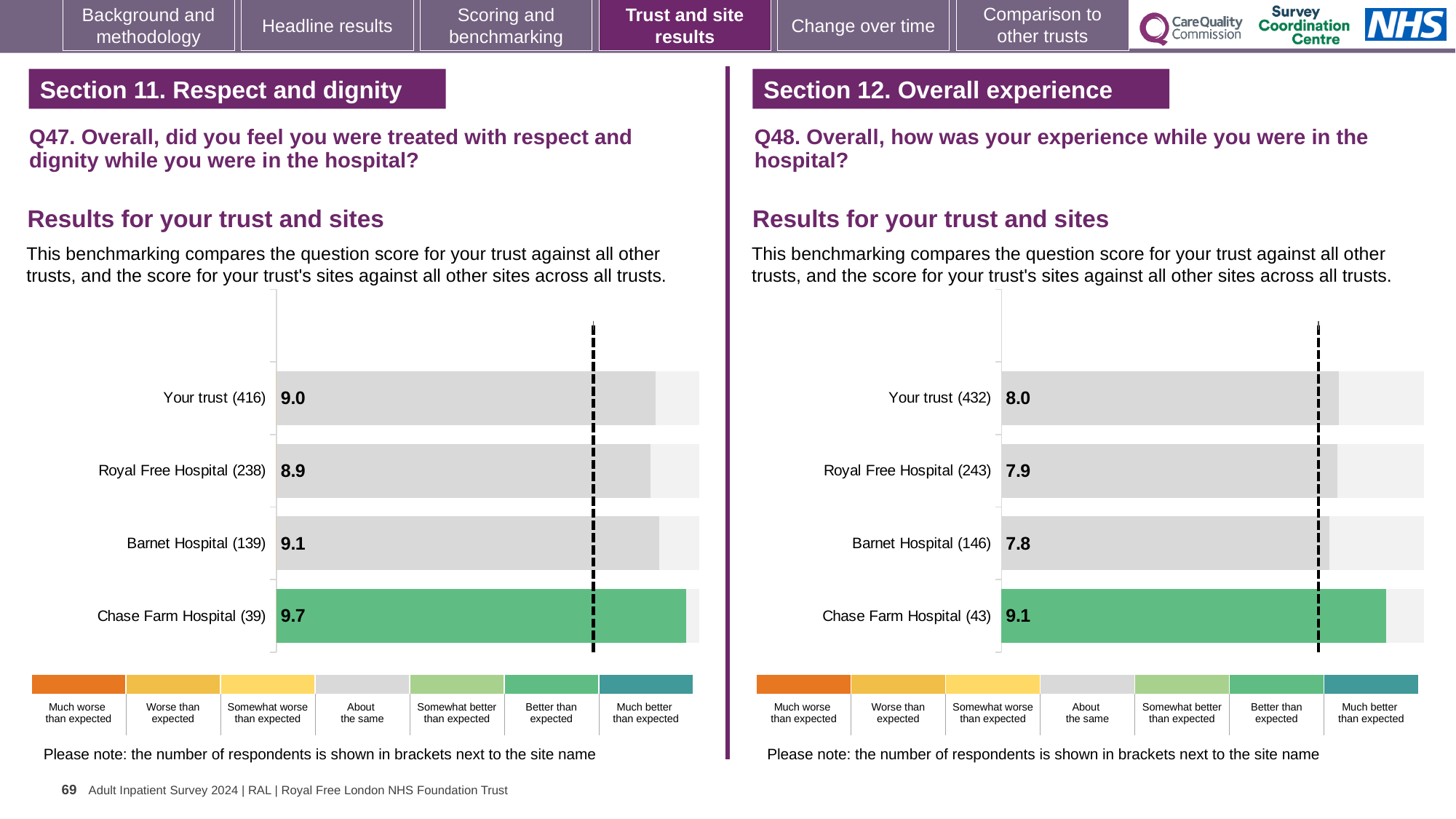
In the Q48 chart on the right, which site has the lowest score? Barnet Hospital How many bars are shown in the Q48 chart on the right? 4 In the Q48 chart on the right, what is the difference between the scores for Chase Farm Hospital and Your trust? 1.1 In the Q47 chart on the left, what is the score for Chase Farm Hospital? 9.7 In the Q47 chart on the left, which site has the highest score? Chase Farm Hospital In the Q47 chart on the left, what is the score for Your trust? 9.0 What type of chart is used in the Q47 chart on the left? Bar chart In the Q47 chart on the left, what is the difference between the scores for Chase Farm Hospital and Royal Free Hospital? 0.8 In the Q48 chart on the right, what is the score for Royal Free Hospital? 7.9 In the Q48 chart on the right, what is the score for Barnet Hospital? 7.8 In the Q48 chart on the right, how many respondents are shown in brackets for Chase Farm Hospital? 43 In the Q47 chart on the left, which has the higher score, Barnet Hospital or Royal Free Hospital? Barnet Hospital